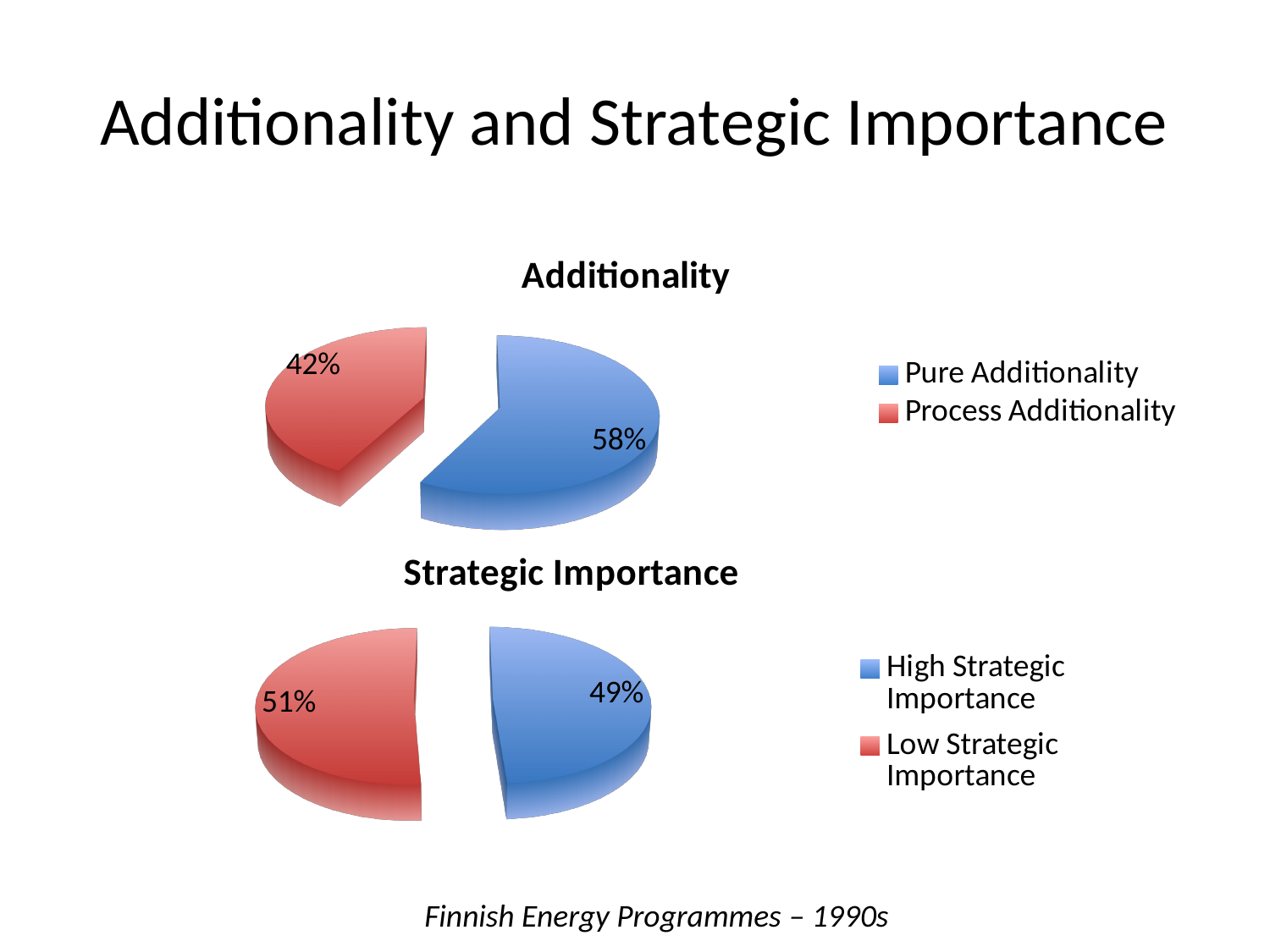
In the Additionality chart, what is the difference in percentage points between Pure Additionality and Process Additionality? 16 In the Strategic Importance chart, what share of the pie is High Strategic Importance? 49% How many slices does the Strategic Importance chart have? 2 In the Additionality chart, what share of the pie is Process Additionality? 42% In the Additionality chart, which category has the largest slice? Pure Additionality In the Strategic Importance chart, which category has the smallest slice? High Strategic Importance In the Strategic Importance chart, what colour is the Low Strategic Importance slice? Red In the Strategic Importance chart, what is the difference in percentage points between Low Strategic Importance and High Strategic Importance? 2 In the Strategic Importance chart, what share of the pie is Low Strategic Importance? 51% What kind of chart is the Additionality chart? Pie chart How many entries does the legend of the Additionality chart list? 2